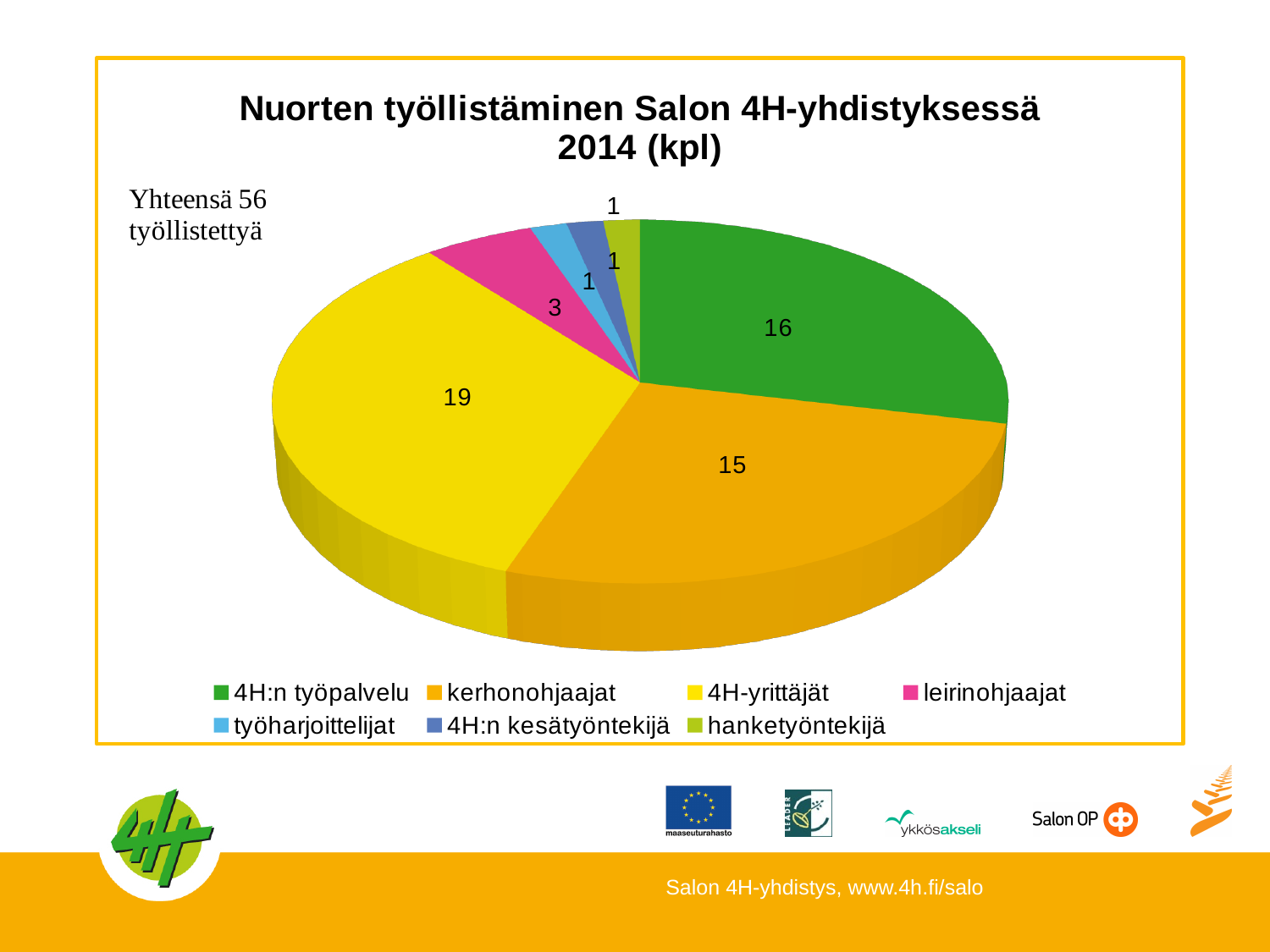
What type of chart is shown on the slide? Pie chart What is the value for kerhonohjaajat? 15 What is the value for leirinohjaajat? 3 What is the value for työharjoittelijat? 1 What is the value for 4H-yrittäjät? 19 Which category has the largest slice of the pie? 4H-yrittäjät How many categories does the pie chart have? 7 What is the difference between the values for 4H-yrittäjät and kerhonohjaajat? 4 What is the total number of employed youths stated on the slide? 56 What is the title of the chart? Nuorten työllistäminen Salon 4H-yhdistyksessä 2014 (kpl) What is the value for 4H:n työpalvelu? 16 Which is larger, the value for 4H:n työpalvelu or the value for kerhonohjaajat? 4H:n työpalvelu